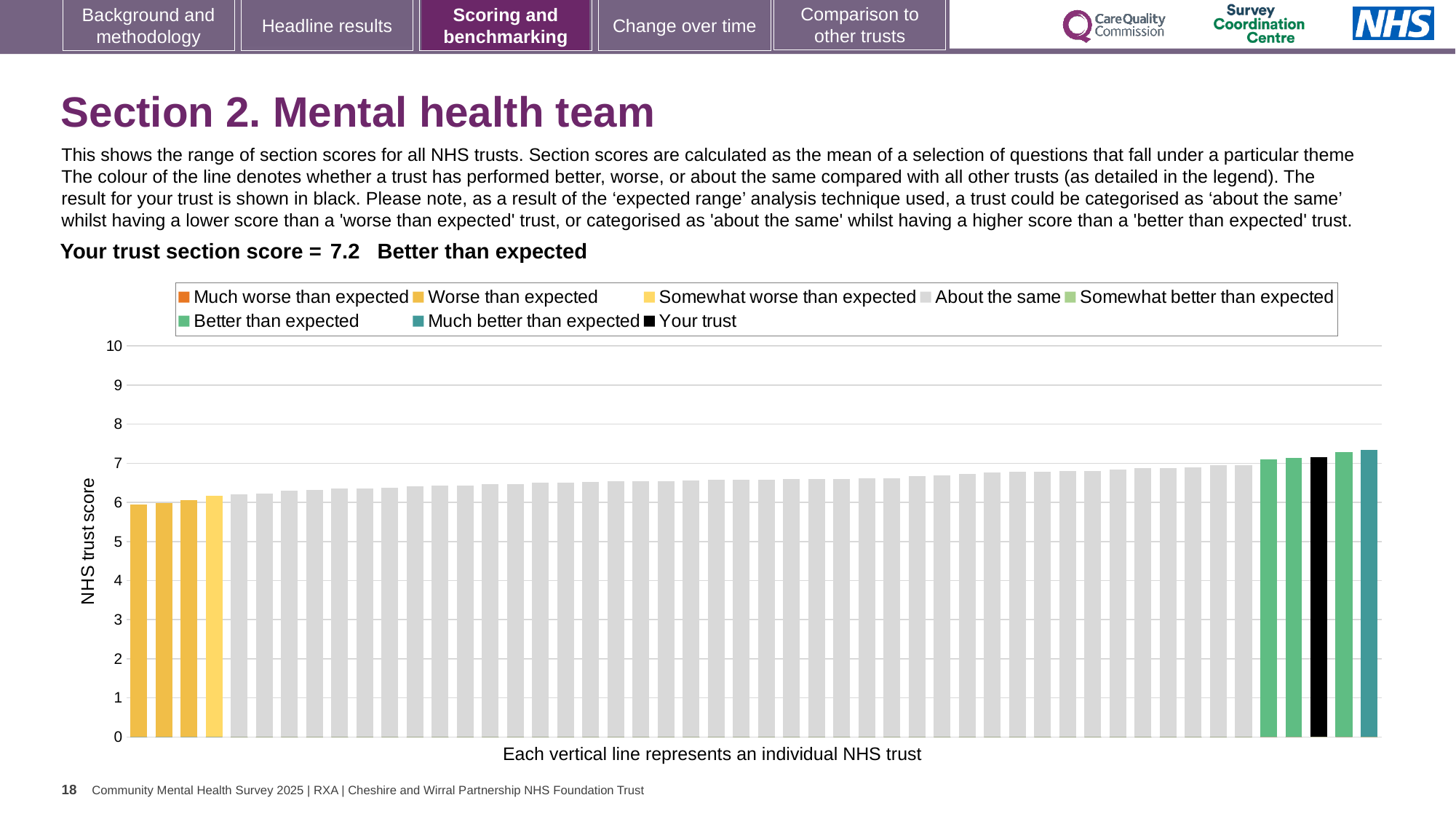
How many entries does the chart legend list? 8 Is the value for your trust (the black bar) greater or less than 7? greater What is the highest value shown on the y axis? 10 How many bars in the chart are black (your trust)? 1 What is the section score for your trust shown on the slide? 7.2 Do the bar values rise or fall from left to right along the x axis? rise What kind of chart is shown on the slide? bar chart How is your trust's section score categorised on the slide? Better than expected Is the lowest bar in the chart greater or less than 5? greater What colour is the bar representing your trust? black What is the label on the y axis of the chart? NHS trust score Is the highest bar in the chart greater or less than 8? less